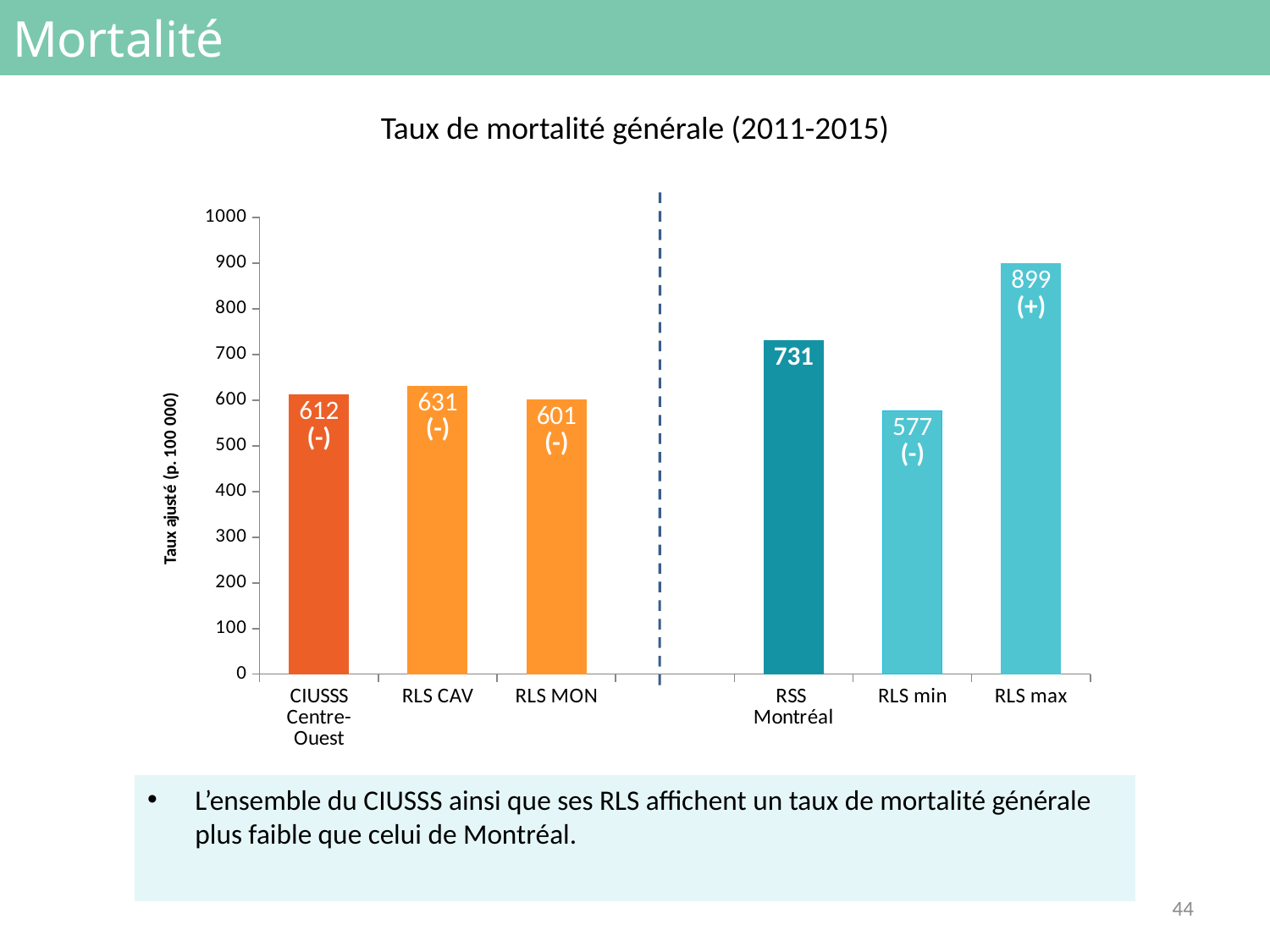
Is the value for RLS max greater or less than 800? greater What is the difference between the values for RSS Montréal and CIUSSS Centre-Ouest? 119 Which category has the highest value? RLS max Which is larger, the value for RLS CAV or the value for RLS MON? RLS CAV What kind of chart is shown on the slide? bar chart What is the value for RLS min? 577 What is the value for CIUSSS Centre-Ouest? 612 How many bars are shown in the chart? 6 What is the difference between the values for RLS max and RLS min? 322 Which category has the lowest value? RLS min What is the value for RSS Montréal? 731 What is the title of the chart? Taux de mortalité générale (2011-2015)